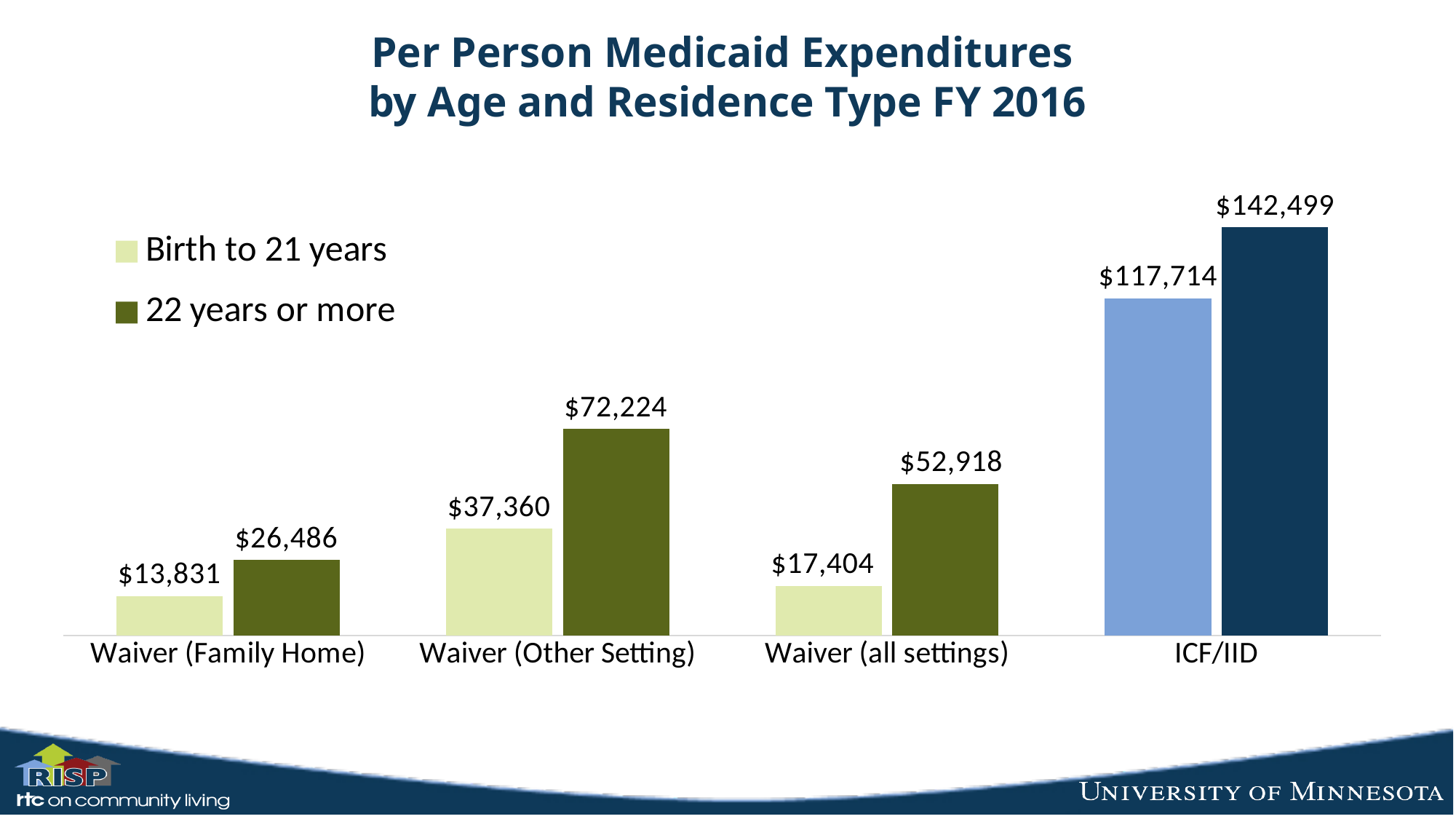
Which residence type has the lowest per person expenditure for Birth to 21 years? Waiver (Family Home) How many series does the legend list? 2 What is the difference between the two bars shown for ICF/IID? $24,785 What is the value for Birth to 21 years in Waiver (all settings)? $17,404 What is the value for 22 years or more in Waiver (Other Setting)? $72,224 What is the value of the taller (right) bar for ICF/IID? $142,499 Which is larger: the 22 years or more value for Waiver (Family Home) or the Birth to 21 years value for Waiver (Other Setting)? Birth to 21 years value for Waiver (Other Setting) What is the per person Medicaid expenditure for Birth to 21 years in Waiver (Family Home)? $13,831 How many residence type categories are shown on the x axis? 4 Which residence type has the highest per person expenditure for 22 years or more? ICF/IID What is the difference between the 22 years or more and Birth to 21 years values in Waiver (Other Setting)? $34,864 What kind of chart is shown on the slide? Bar chart